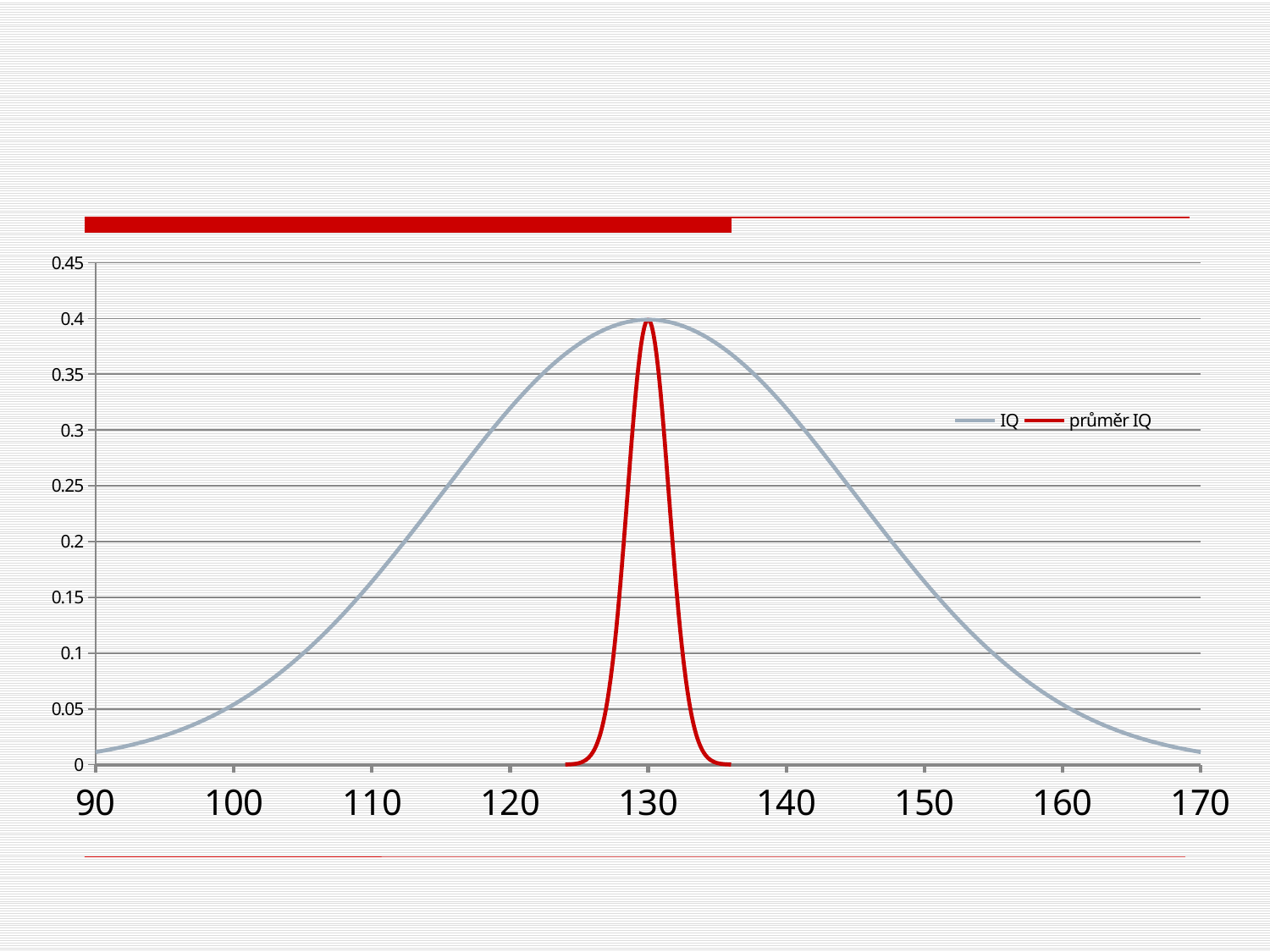
Does the IQ series rise or fall between 90 and 130 on the x axis? rise What kind of chart is shown on the slide? line chart Is the value of the IQ series at 170 greater or less than 0.05? less At which x-axis value does the průměr IQ series reach its highest point? 130 At which x-axis value does the IQ series reach its highest point? 130 Is the value of the IQ series at 90 greater or less than 0.05? less What are the two series named in the legend? IQ and průměr IQ Does the IQ series rise or fall between 130 and 170 on the x axis? fall Is the value of the IQ series at 130 greater or less than 0.35? greater How many series does the legend list? 2